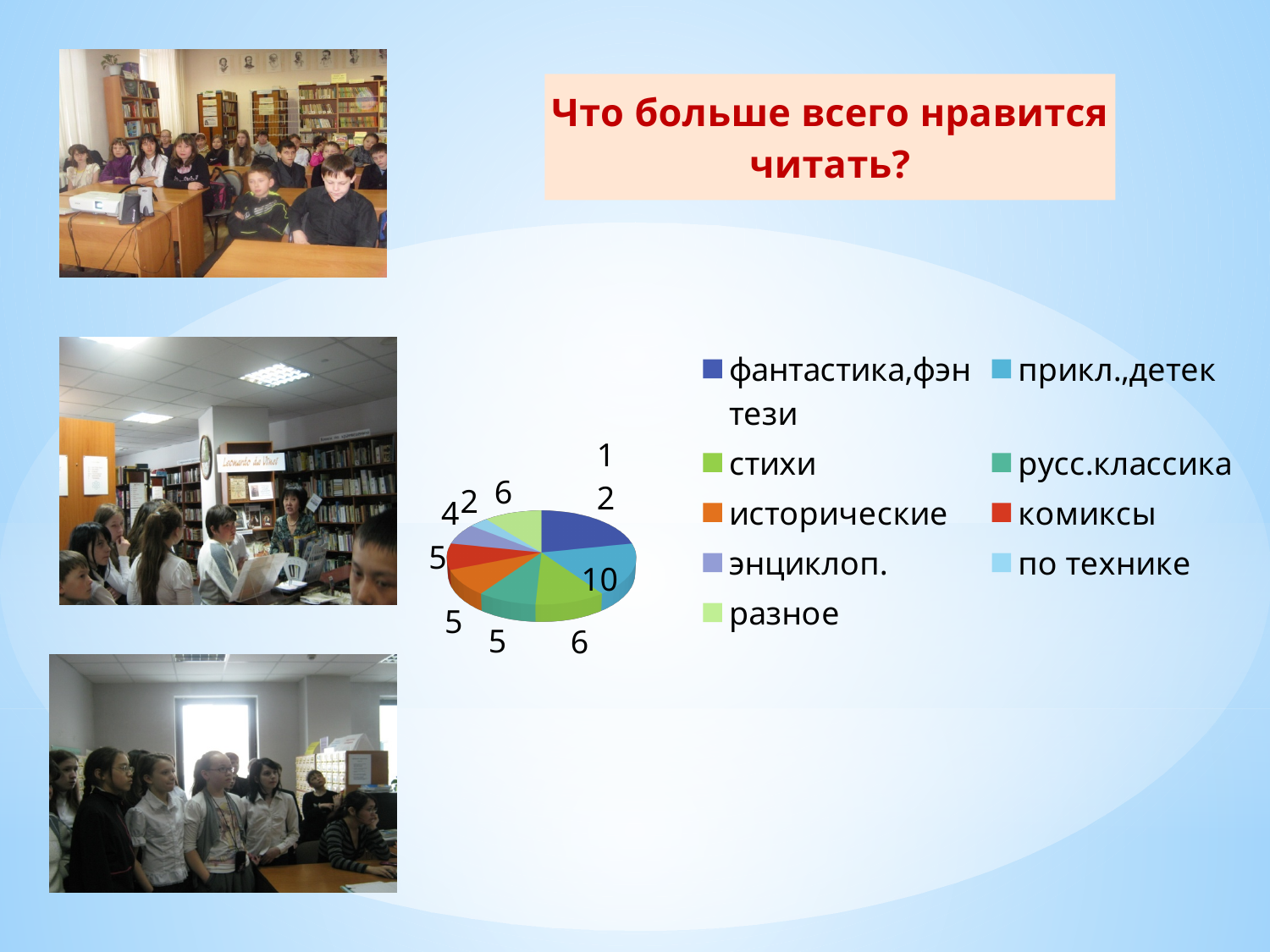
What is the difference between the values for прикл.,детек and стихи? 4 What is the value for энциклоп. in the pie chart? 4 Which category has the smallest slice in the pie chart? по технике What is the title shown above the pie chart? Что больше всего нравится читать? What is the value for разное in the pie chart? 6 How many categories does the legend of the pie chart list? 9 What kind of chart is shown on the slide? pie chart What is the value for по технике in the pie chart? 2 What is the value for стихи in the pie chart? 6 What is the value for прикл.,детек in the pie chart? 10 What is the value for комиксы in the pie chart? 5 Which is larger in the pie chart, стихи or энциклоп.? стихи